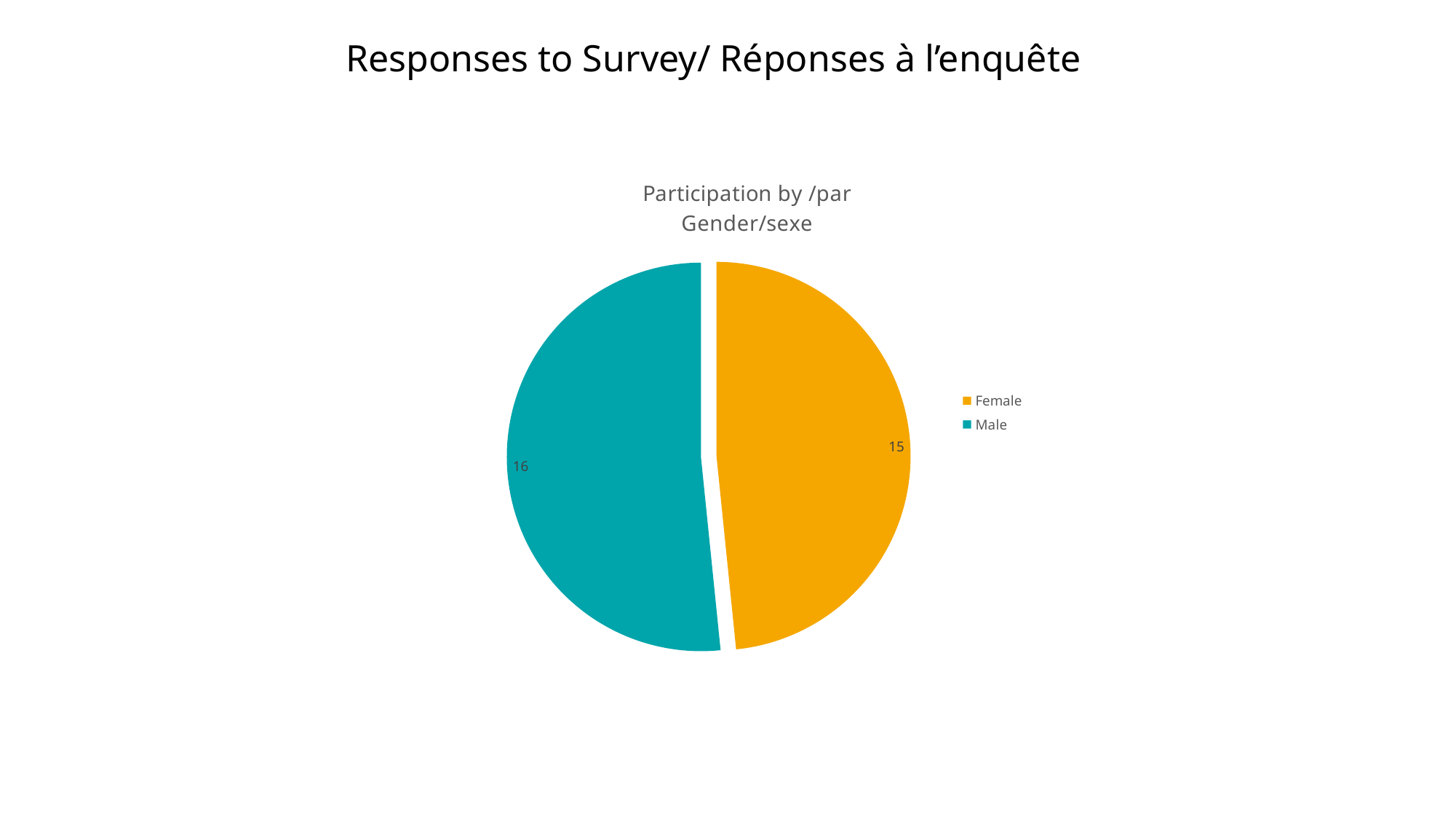
Which category has the lowest value in the pie chart? Female What is the title of the pie chart? Participation by /par Gender/sexe How many entries does the legend list? 2 What is the difference between the Male and Female values? 1 Which category has the larger value, Female or Male? Male What is the value for Male in the pie chart? 16 How many slices does the pie chart have? 2 What kind of chart is shown on the slide? pie chart What colour is the Male slice in the pie chart? teal What is the total of all slices in the pie chart? 31 What is the value for Female in the pie chart? 15 Which category has the highest value in the pie chart? Male